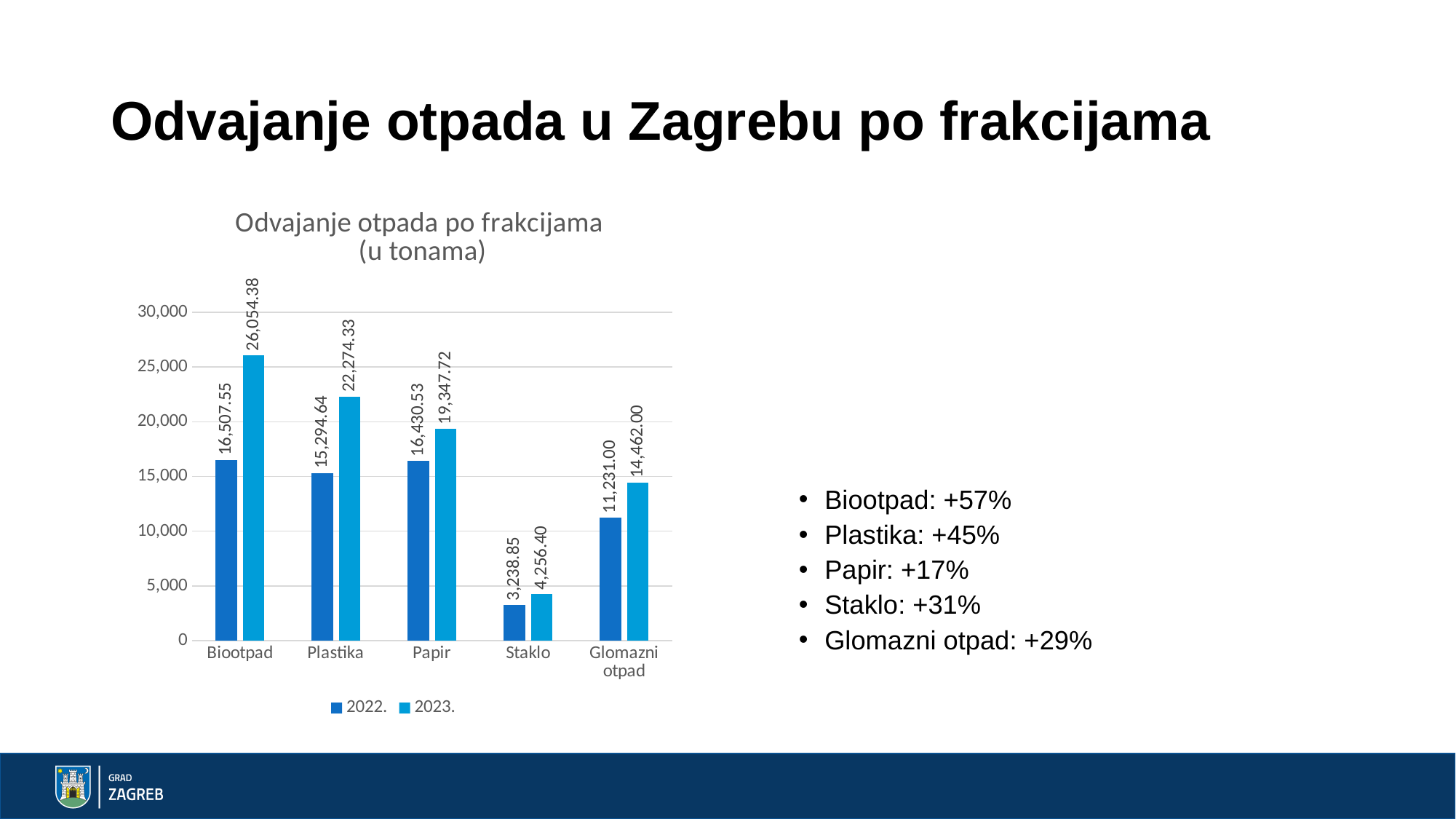
Which is larger: the 2022. value for Papir or the 2022. value for Plastika? Papir What is the difference between the 2023. and 2022. values for Glomazni otpad? 3,231.00 How many series does the legend list? 2 How many categories are shown on the x axis? 5 What kind of chart is shown on the slide? Bar chart What is the 2022. value for Plastika? 15,294.64 What is the 2023. value for Biootpad? 26,054.38 Which category has the highest 2023. value? Biootpad Which category has the lowest 2022. value? Staklo What is the difference between the 2023. and 2022. values for Biootpad? 9,546.83 What is the 2023. value for Glomazni otpad? 14,462.00 What is the 2022. value for Staklo? 3,238.85